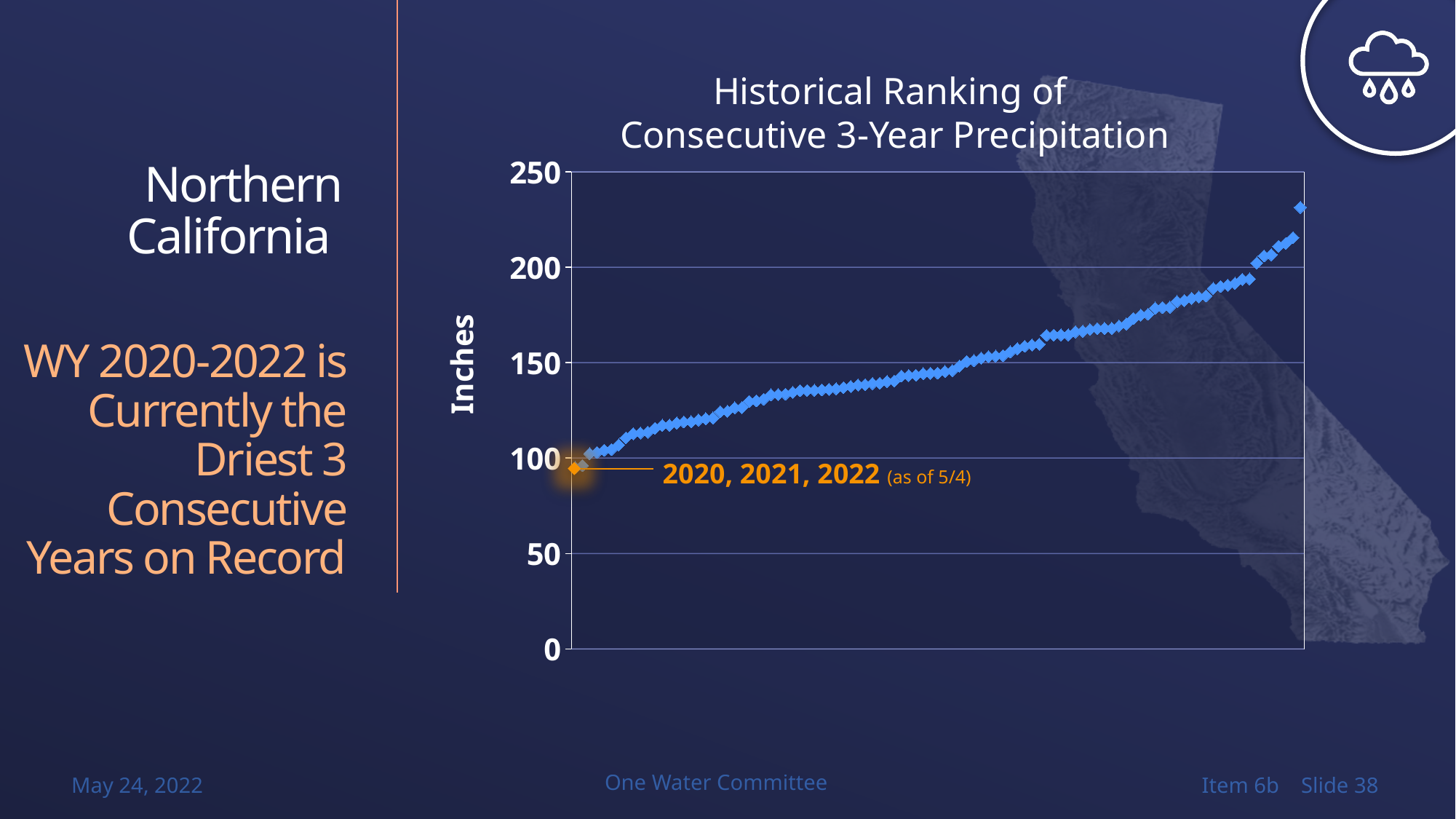
Is the highest point on the chart greater or less than 250? less What is the label on the vertical axis of the chart? Inches Which point on the chart is highlighted in orange? 2020, 2021, 2022 (as of 5/4) What is the title of the chart? Historical Ranking of Consecutive 3-Year Precipitation Do the plotted values rise or fall from left to right along the x axis? rise Is the lowest point on the chart greater or less than 50? greater What is the maximum value shown on the vertical axis? 250 Is the highest point on the chart greater or less than 200? greater Where on the chart does the 2020, 2021, 2022 point appear: at the far left or the far right? far left